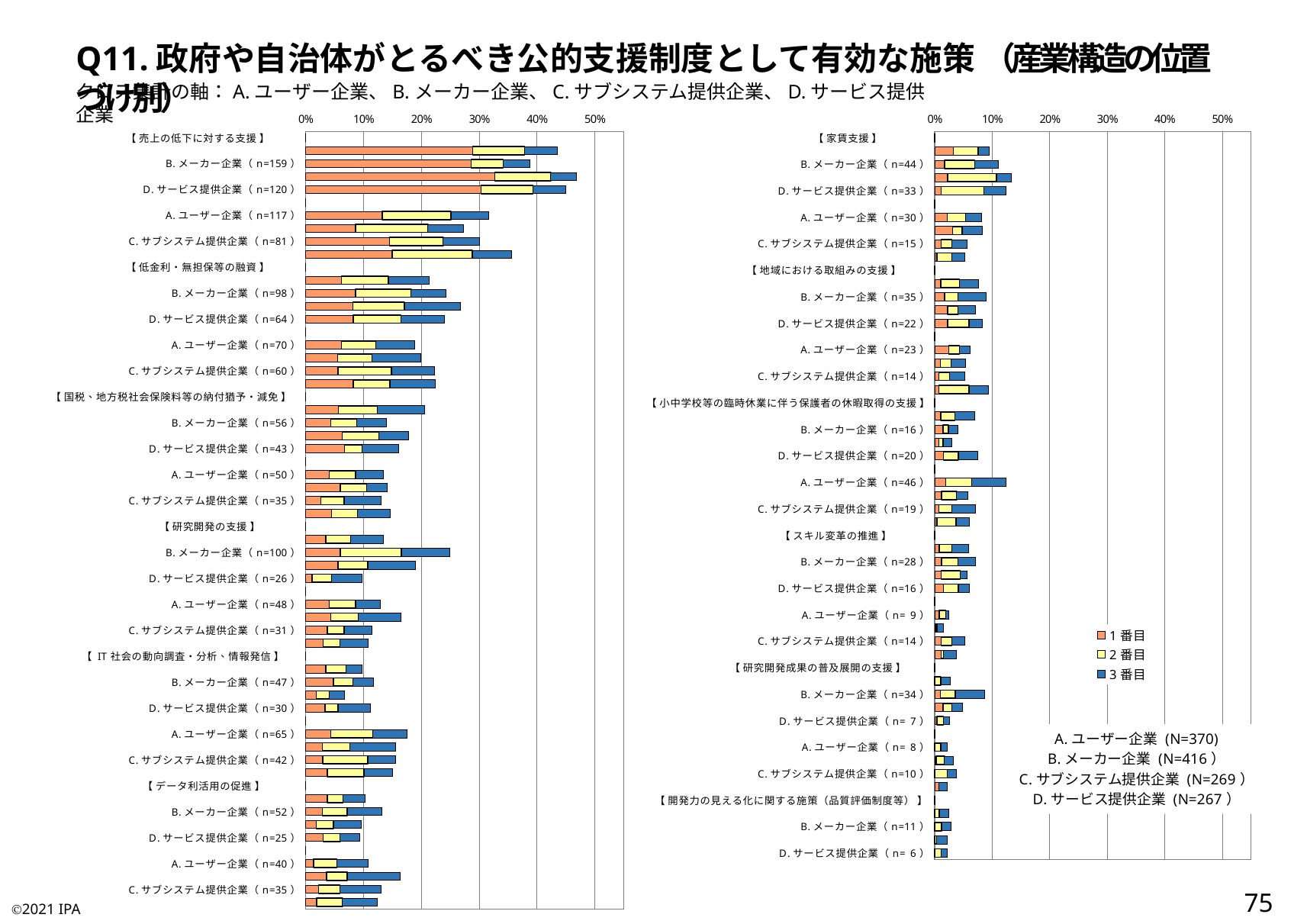
In the right chart, is the longest bar greater or less than 20%? less In the left chart, which group has longer bars: 【売上の低下に対する支援】 or 【データ利活用の促進】? 【売上の低下に対する支援】 What is the maximum value shown on the x axis of the right chart? 50% What are the three legend entries for the charts? 1番目, 2番目, 3番目 What kind of chart is shown on the left side of the slide? bar chart How many series does the legend list for the charts? 3 In the right chart, is the first bar under 【家賃支援】 greater or less than 5%? greater In the left chart, is the longest bar under 【売上の低下に対する支援】 greater or less than 40%? greater In the left chart, which group of bars reaches the highest values? 【売上の低下に対する支援】